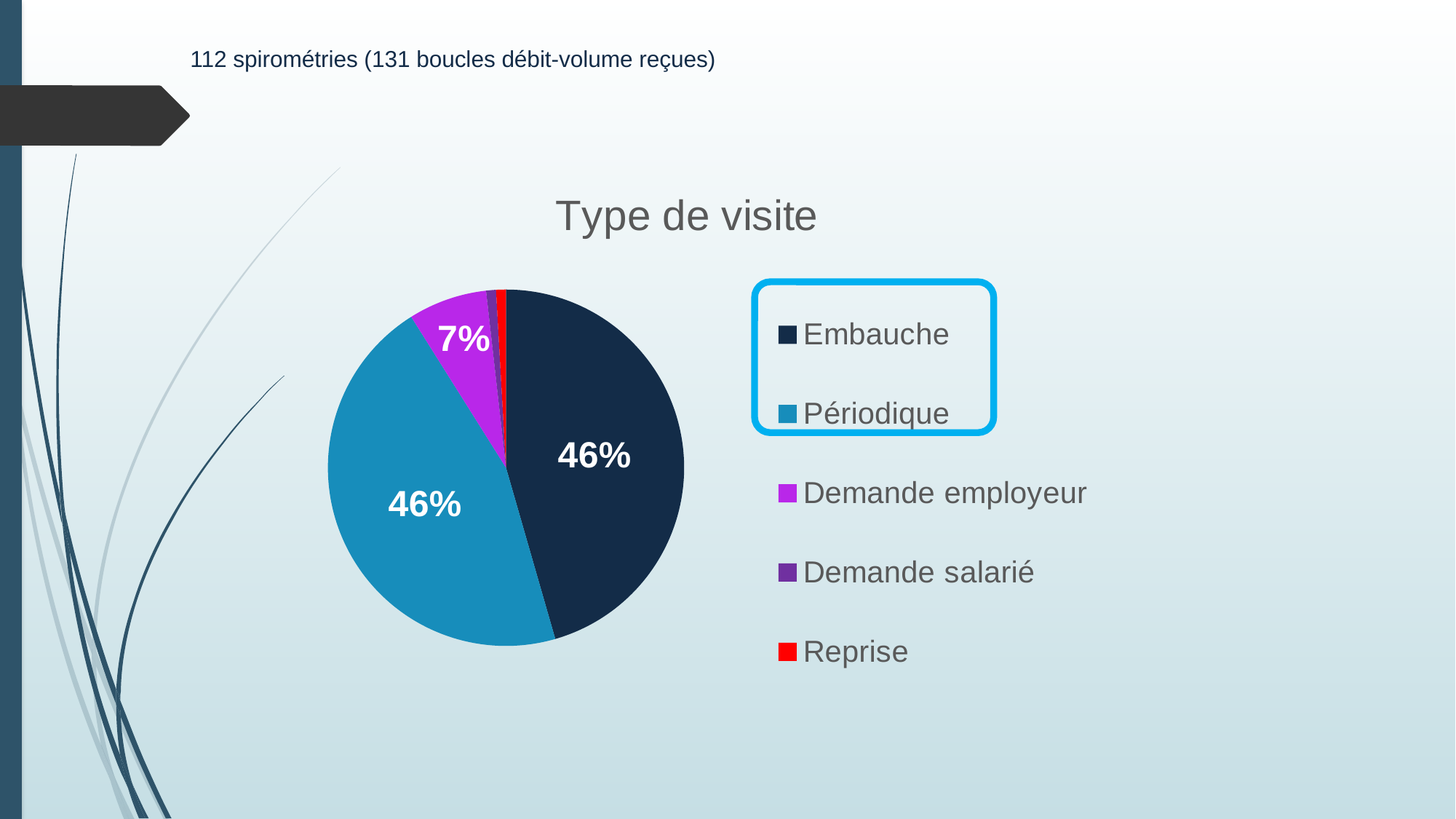
What kind of chart is shown on the slide? pie chart What share of the pie does Embauche represent? 46% What is the difference between the share for Périodique and the share for Demande employeur? 39% What is the title of the chart? Type de visite What share of the pie does Périodique represent? 46% Which two legend entries are enclosed in a highlighted box? Embauche and Périodique Which is larger, the slice for Embauche or the slice for Demande employeur? Embauche What colour is the Reprise slice of the pie chart? red Which is larger, the slice for Périodique or the slice for Reprise? Périodique How many categories does the legend of the pie chart list? 5 What is the combined share of Embauche and Périodique? 92% What is the value shown for Demande employeur? 7%